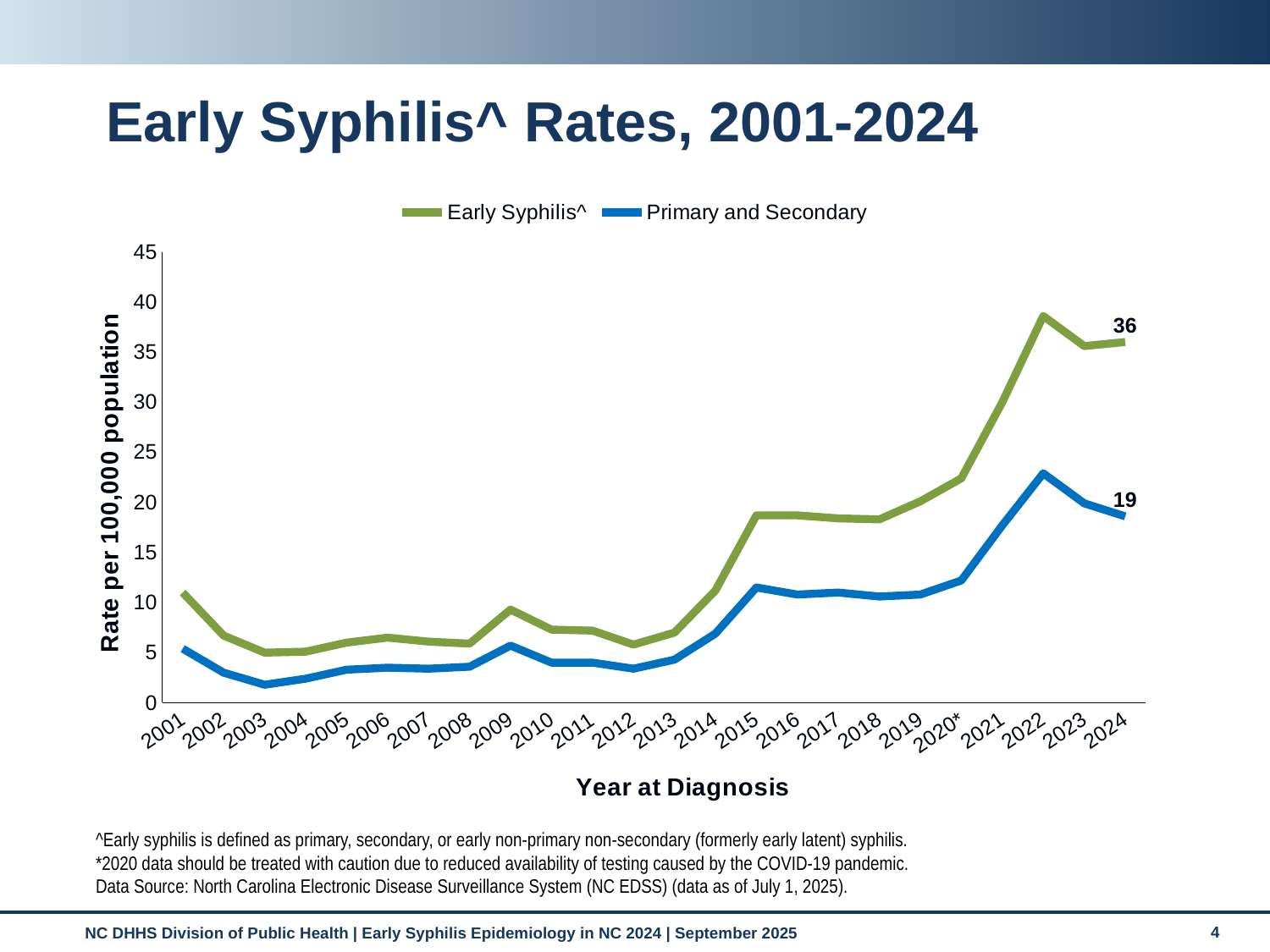
In which year does the Early Syphilis^ rate reach its highest point? 2022 Is the Primary and Secondary rate in 2015 greater or less than 10? greater What is the title of the x axis? Year at Diagnosis Which year has the higher Early Syphilis^ rate, 2009 or 2012? 2009 What is the Primary and Secondary rate per 100,000 population in 2024? 19 Is the Early Syphilis^ rate in 2022 greater or less than 35? greater In 2024, how much higher is the Early Syphilis^ rate than the Primary and Secondary rate? 17 What is the Early Syphilis^ rate per 100,000 population in 2024? 36 How many series does the legend list? 2 How many years are plotted along the x axis? 24 What kind of chart is shown on the slide? Line chart